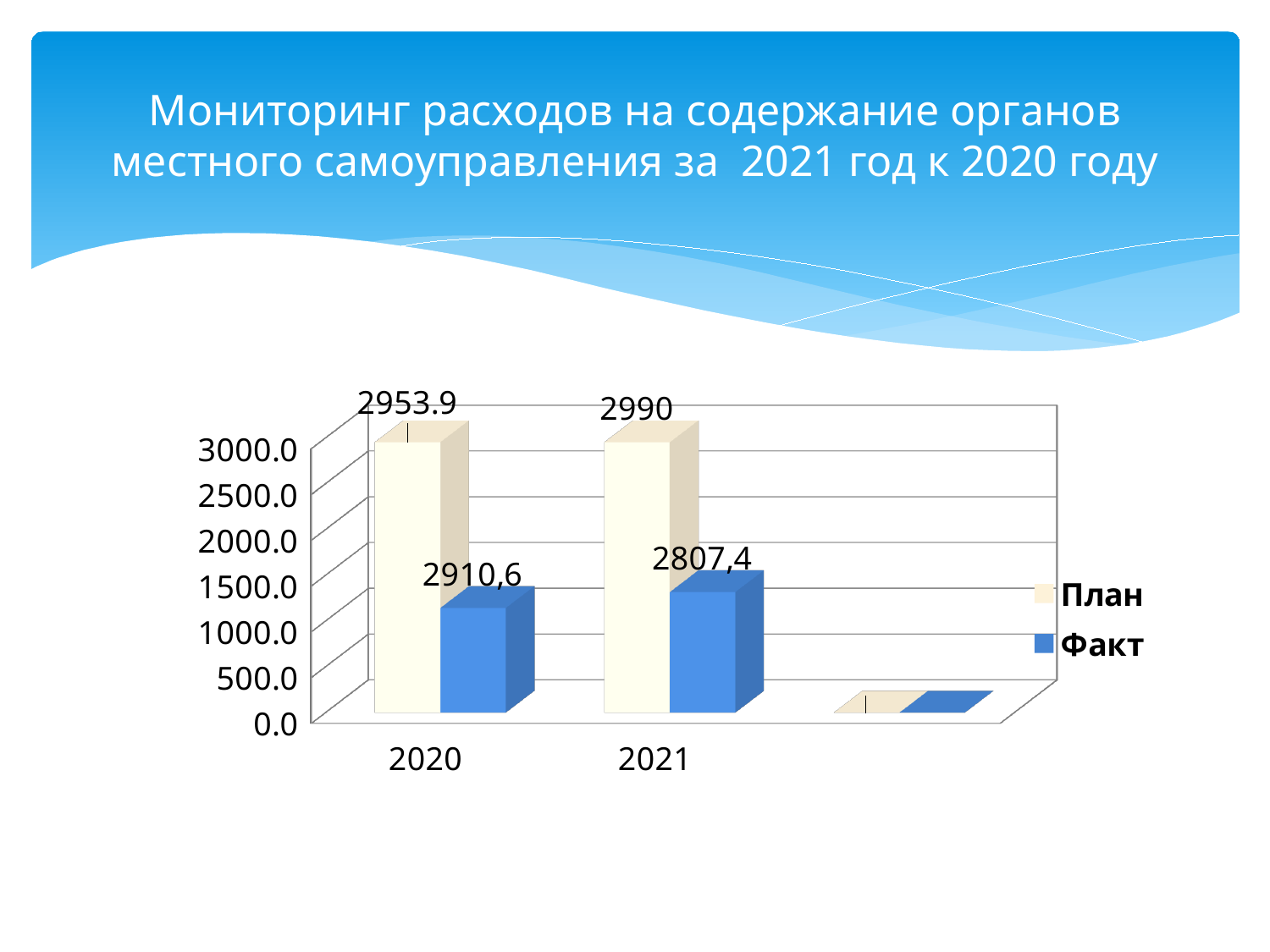
Which year has the higher План value? 2021 What is the Факт value for 2020? 2910,6 What is the difference between the План values for 2021 and 2020? 36.1 How many series does the legend list? 2 What is the План value for 2021? 2990 Which is larger in 2021, План or Факт? План What is the План value for 2020? 2953.9 What is the difference between the Факт values for 2020 and 2021? 103,2 What kind of chart is shown on the slide? bar chart What is the Факт value for 2021? 2807,4